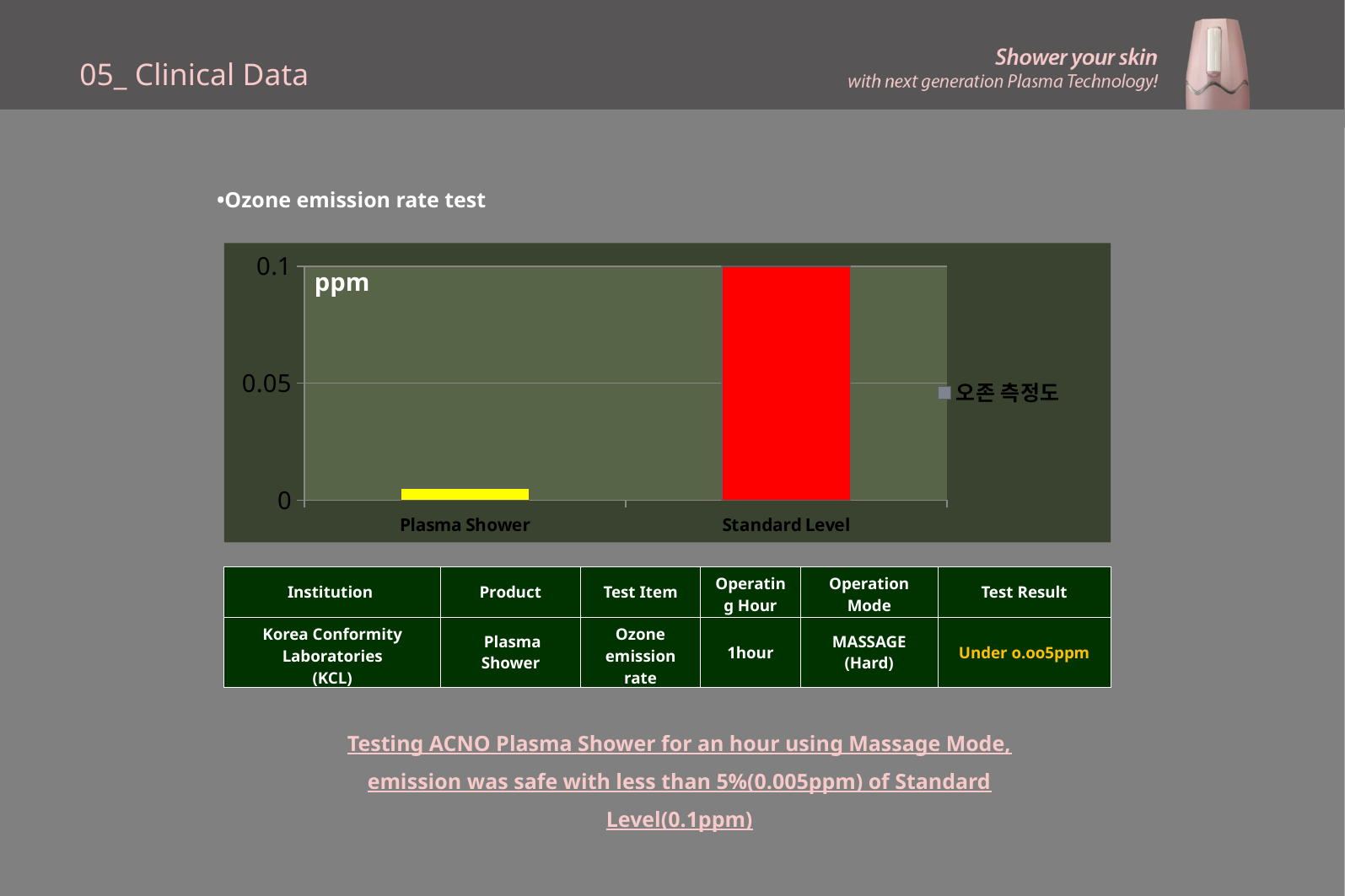
Which category has the lowest value in the chart? Plasma Shower What unit is shown in the top-left corner of the chart's plot area? ppm Is the value for Standard Level greater or less than 0.05? greater How many categories are plotted on the x axis of the chart? 2 Is the value for Plasma Shower greater or less than 0.05? less What kind of chart is shown on the slide? bar chart What value does the Standard Level bar reach on the y axis? 0.1 What colour is the Plasma Shower bar? yellow Which is larger, the value for Plasma Shower or the value for Standard Level? Standard Level Which category has the highest value in the chart? Standard Level How many series does the chart legend list? 1